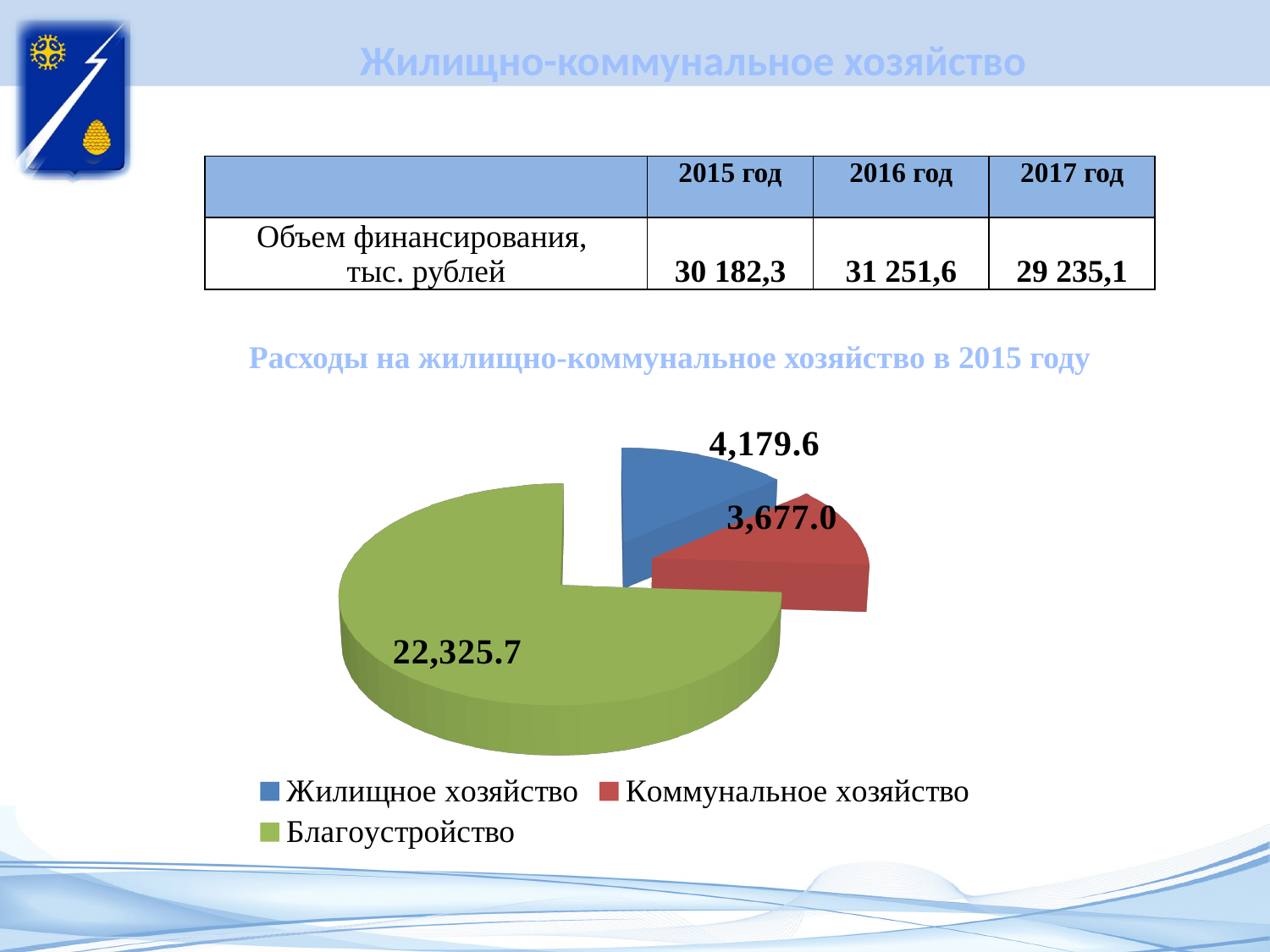
What is the difference between the values for Жилищное хозяйство and Коммунальное хозяйство in the pie chart? 502.6 What is the value for Коммунальное хозяйство in the pie chart? 3,677.0 What is the difference between the values for Благоустройство and Жилищное хозяйство in the pie chart? 18,146.1 What type of chart is shown on the slide? Pie chart How many entries does the legend of the pie chart list? 3 Which is larger in the pie chart: Жилищное хозяйство or Коммунальное хозяйство? Жилищное хозяйство How many slices does the pie chart have? 3 What is the value for Жилищное хозяйство in the pie chart? 4,179.6 Which category has the largest slice in the pie chart? Благоустройство What is the value for Благоустройство in the pie chart? 22,325.7 What colour is the Благоустройство slice in the pie chart? Green Which category has the smallest slice in the pie chart? Коммунальное хозяйство